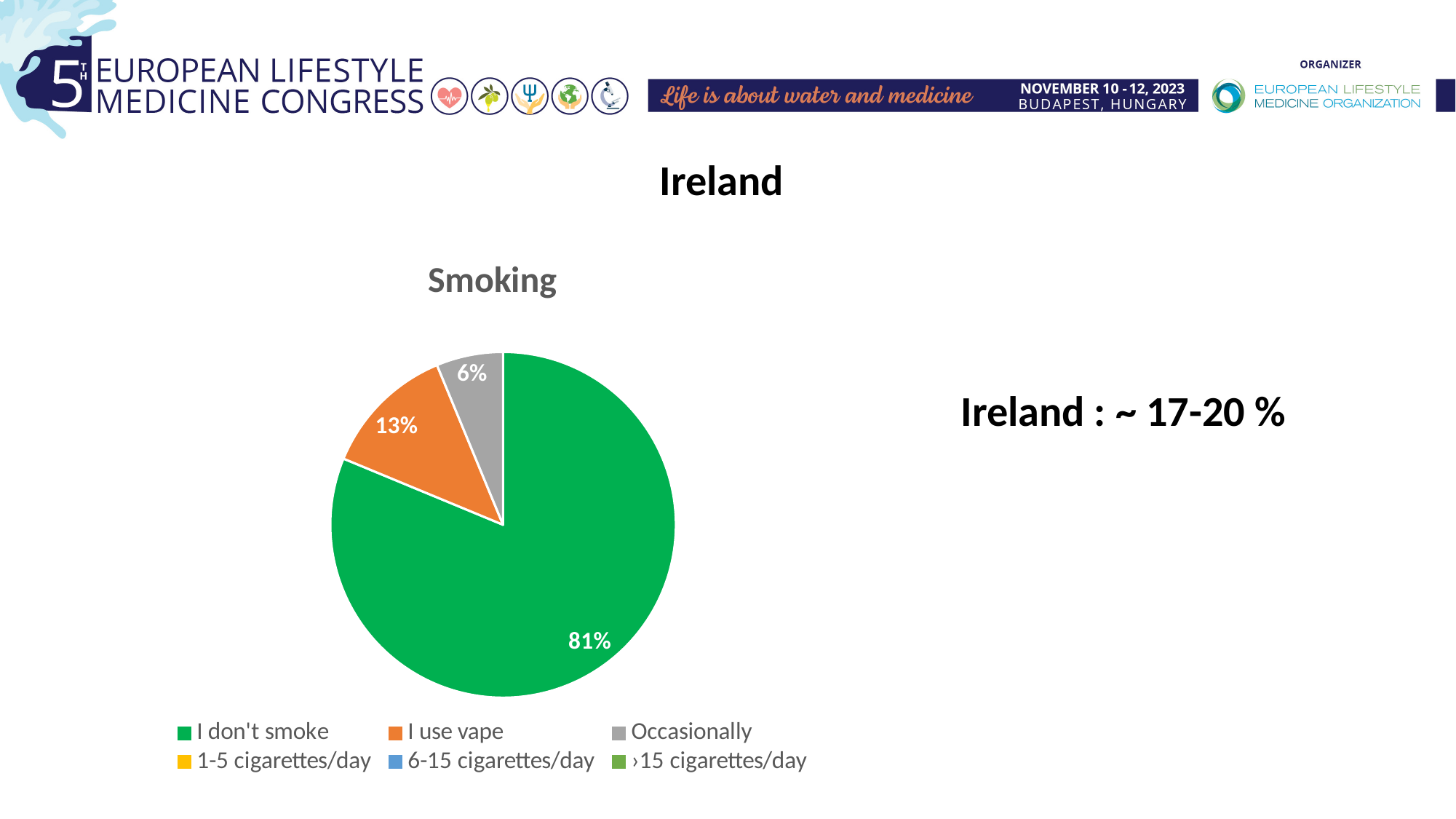
Which category has the largest slice of the pie? I don't smoke What is the difference in percentage points between "I don't smoke" and "I use vape"? 68 What percentage of respondents answered "I use vape"? 13% Which is larger, the share for "I use vape" or the share for "Occasionally"? I use vape Among the slices with printed labels, which category has the smallest share? Occasionally What colour is the "I don't smoke" slice? green What is the difference in percentage points between "I use vape" and "Occasionally"? 7 What percentage of respondents answered "Occasionally"? 6% What type of chart is shown on the slide? pie chart How many categories does the legend list? 6 What percentage of respondents answered "I don't smoke"? 81% What is the title of the chart? Smoking